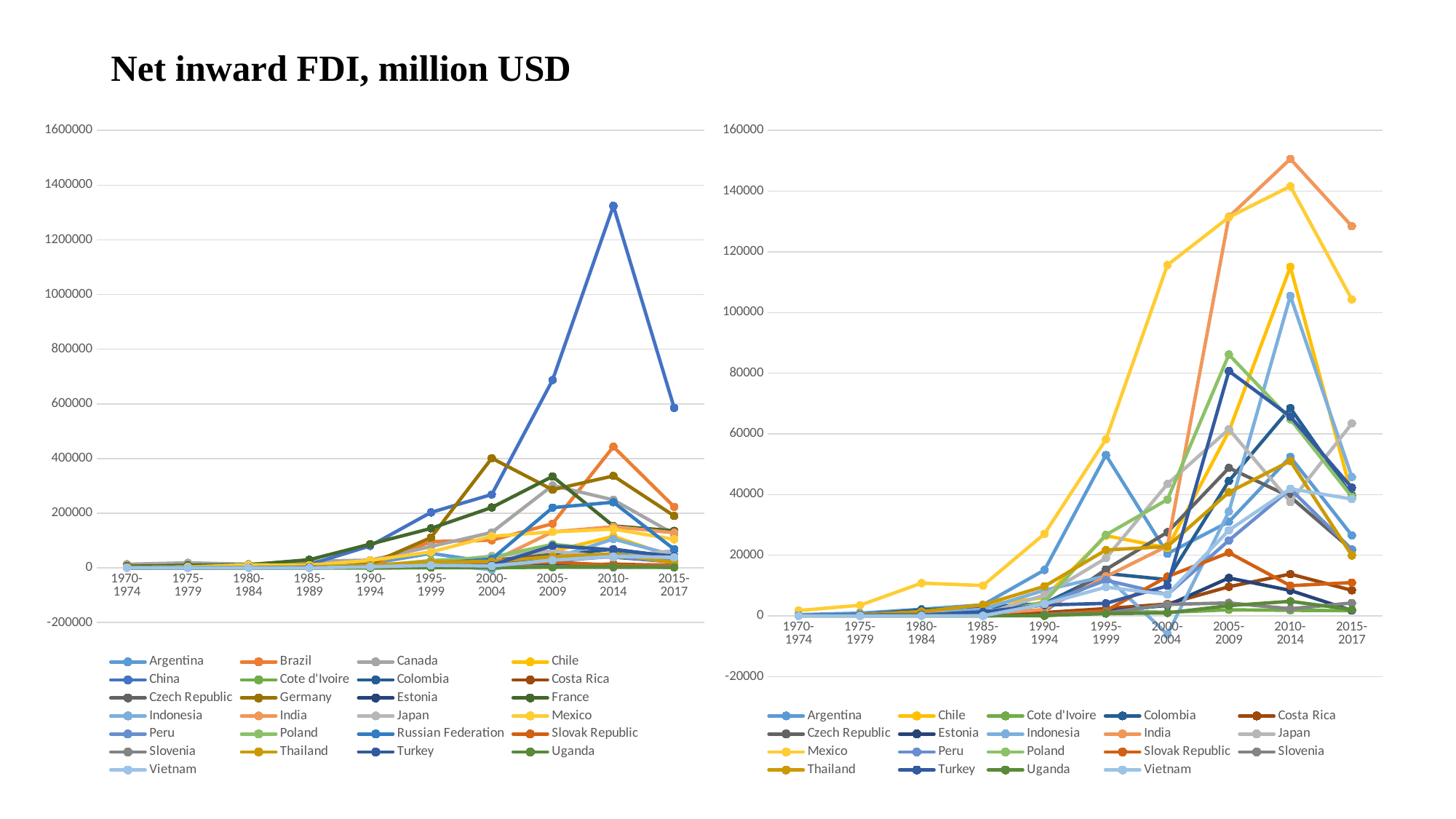
How many series does the legend of the left chart list? 25 In the left chart, does the value for China rise or fall between 2010-2014 and 2015-2017? fall In the right chart, which is larger in 2015-2017, India or Mexico? India How many series does the legend of the right chart list? 19 How many time periods are shown on the x axis of the right chart? 10 What kind of chart is the left chart on the slide? line chart In the right chart, which country reaches the highest value in 2010-2014? India In the right chart, is the value for India in 2010-2014 greater or less than 140000? greater In the left chart, which country reaches the highest value in 2010-2014? China In the left chart, is the value for Brazil in 2010-2014 greater or less than 400000? greater What is the title of the slide? Net inward FDI, million USD In the left chart, is the value for China in 2010-2014 greater or less than 1200000? greater